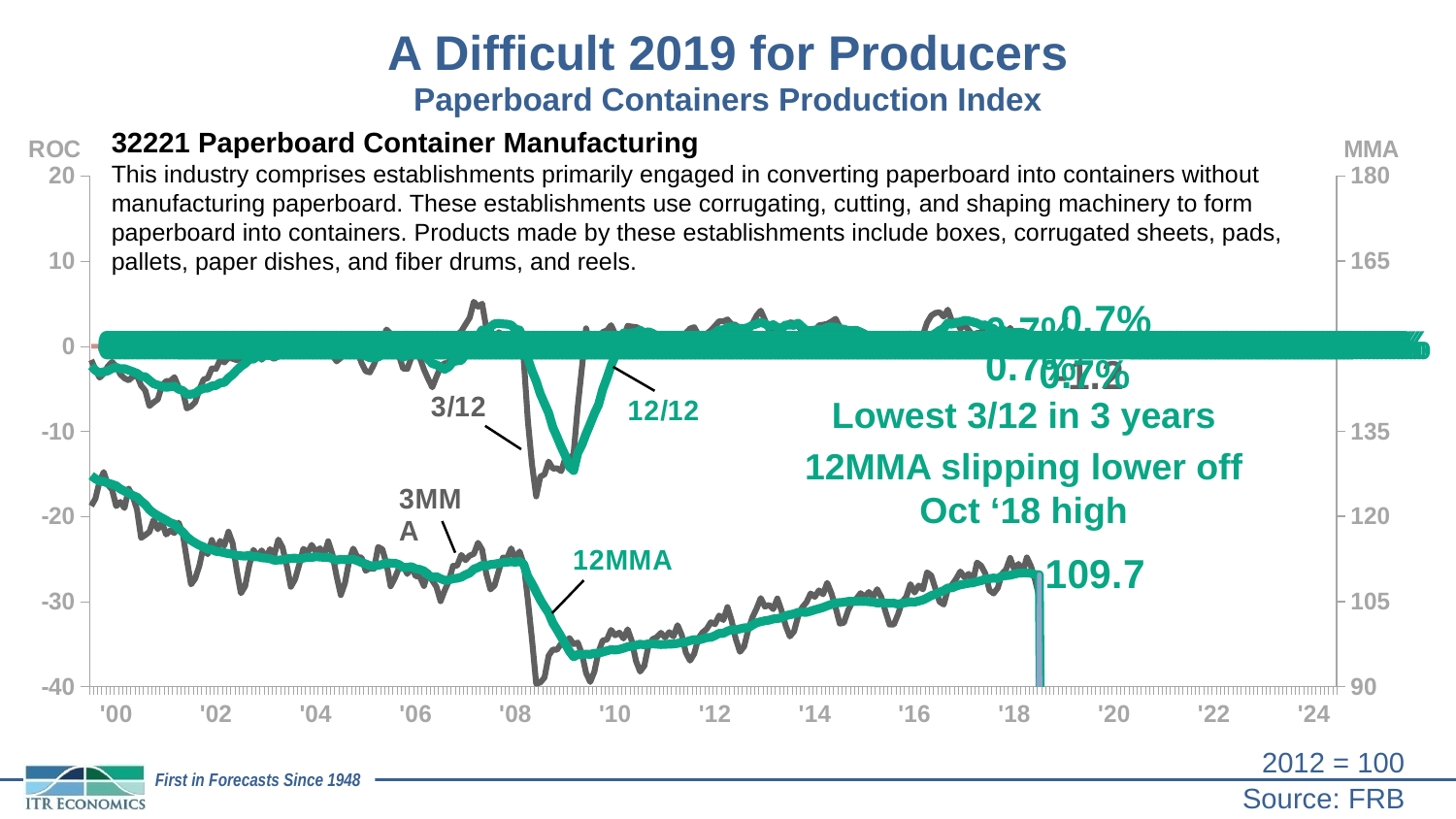
What is the chart's title shown under the main heading? Paperboard Containers Production Index Is the 3MMA value in 2000 greater or less than 120 on the MMA axis? greater Does the 12MMA line rise or fall from 2010 to 2018? rise How many labeled data series (lines) are plotted on the chart? 4 Is the 12MMA value around 2010 greater or less than 105 on the MMA axis? less Does the 12MMA line rise or fall from 2000 to 2008? fall What is the latest labeled value of the 12MMA line? 109.7 Is the 12/12 value at its 2009 low greater or less than -10 on the ROC axis? less What kind of chart is shown on the slide? line chart What is the source of the data cited on the slide? FRB